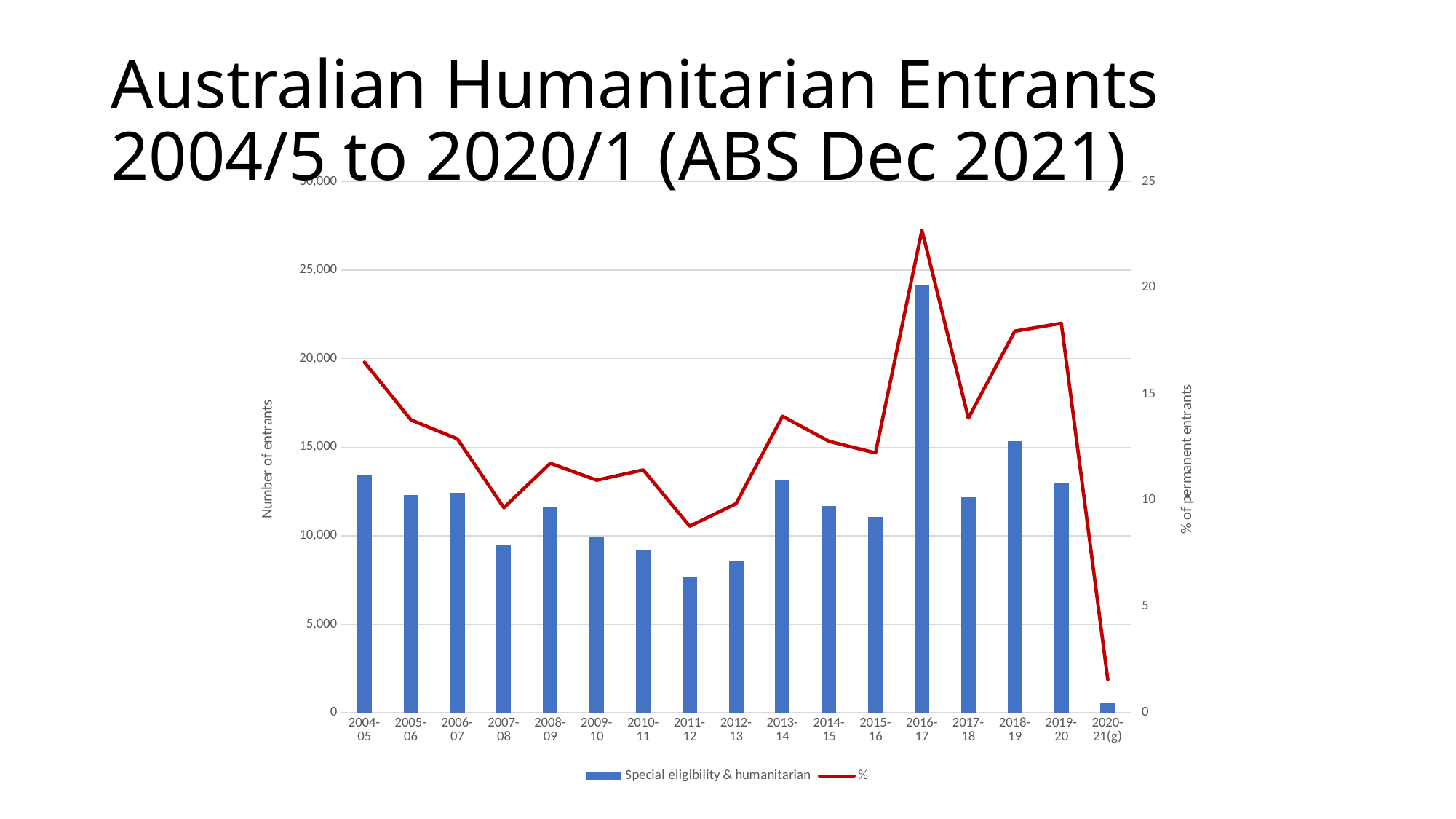
Which year has more Special eligibility & humanitarian entrants, 2018-19 or 2019-20? 2018-19 Which year has the lowest number of Special eligibility & humanitarian entrants? 2020-21(g) Is the % value for 2004-05 greater or less than 15? greater What kind of chart is shown on the slide? A combined bar and line chart In which year does the % line reach its highest point? 2016-17 Is the number of Special eligibility & humanitarian entrants in 2016-17 greater or less than 20,000? greater Which year has the highest number of Special eligibility & humanitarian entrants? 2016-17 How many year categories are shown on the x axis? 17 What is the label of the right-hand vertical axis? % of permanent entrants How many series does the legend list? 2 Do the Special eligibility & humanitarian bars rise or fall from 2004-05 to 2007-08? fall Is the number of Special eligibility & humanitarian entrants in 2011-12 greater or less than 10,000? less